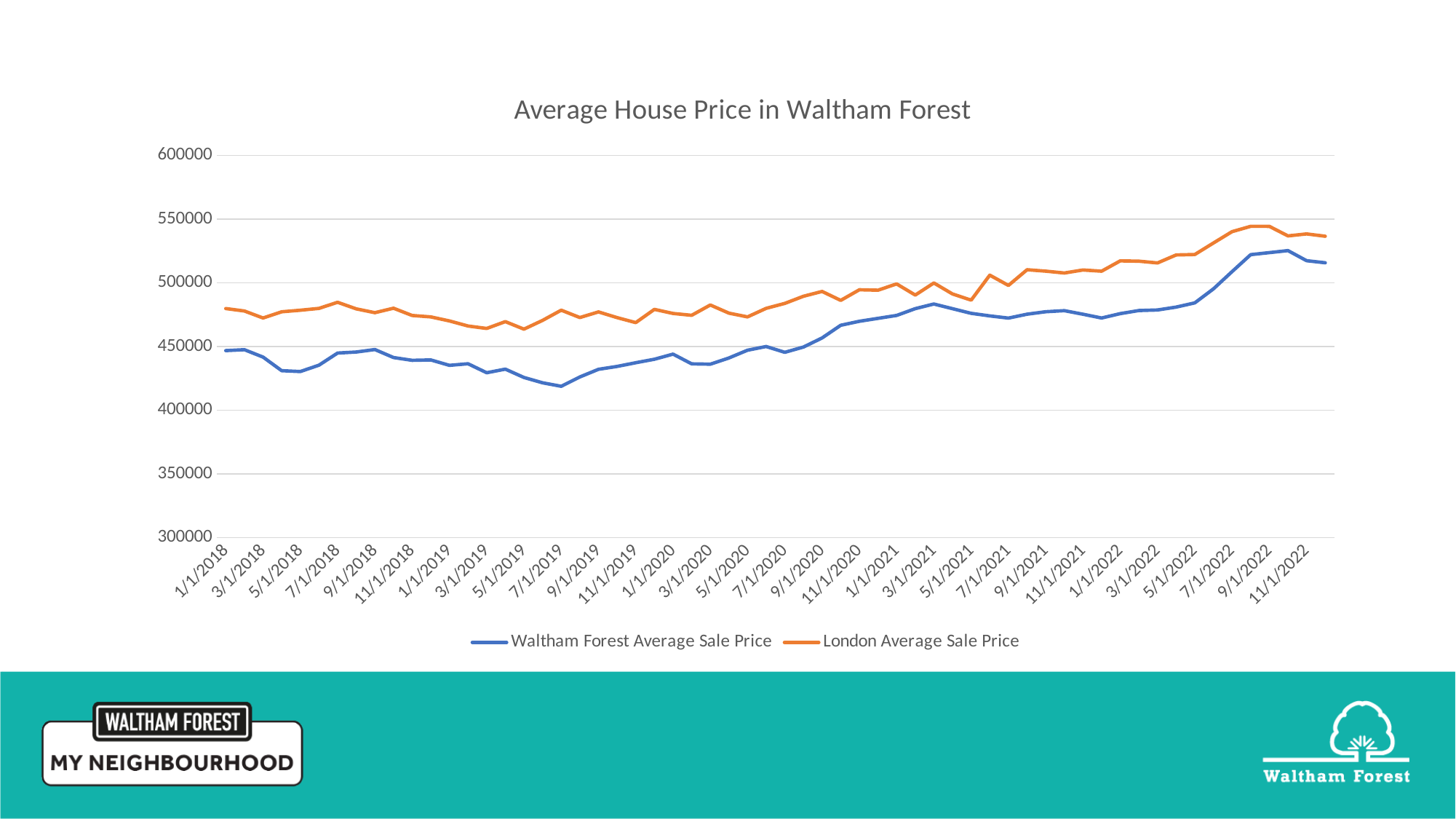
Is the London Average Sale Price at 9/1/2022 greater or less than 500000? greater Does the Waltham Forest Average Sale Price rise or fall between 1/1/2021 and 9/1/2022? rise What is the title of the chart? Average House Price in Waltham Forest Is the Waltham Forest Average Sale Price at 7/1/2019 greater or less than 450000? less Which series is drawn in orange? London Average Sale Price Is the London Average Sale Price at 1/1/2018 greater or less than 500000? less How many series does the legend list? 2 At 1/1/2018, which is higher: the London Average Sale Price or the Waltham Forest Average Sale Price? London Average Sale Price Which series reaches the highest value on the chart? London Average Sale Price What kind of chart is shown on the slide? line chart